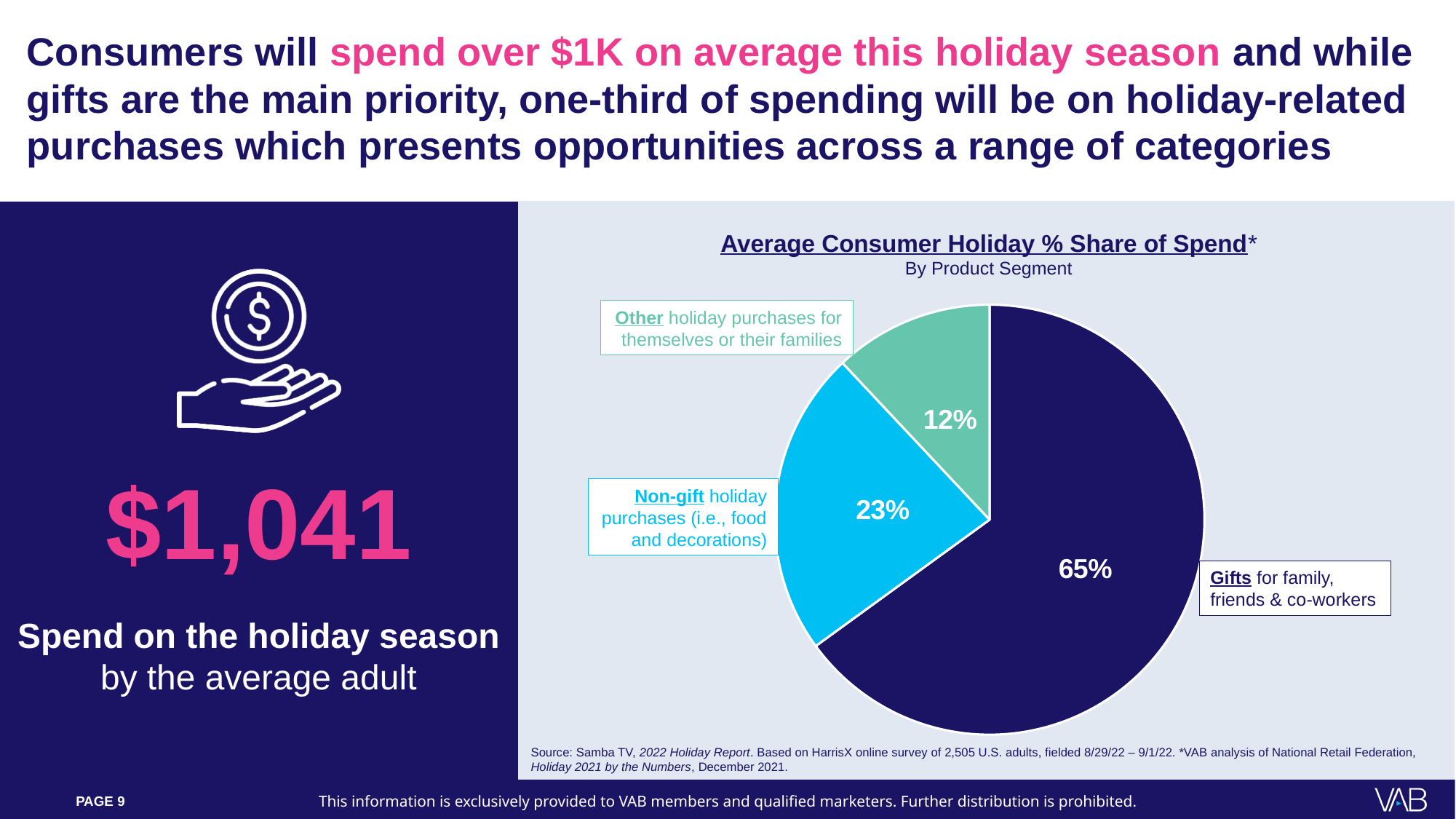
What kind of chart is used to show the share of spend by product segment? Pie chart What colour is the slice for non-gift holiday purchases? Light blue What share of holiday spend goes to non-gift holiday purchases (i.e., food and decorations)? 23% Which product segment has the smallest share of holiday spend? Other holiday purchases for themselves or their families How many product segments are shown in the pie chart? 3 Which has a larger share of spend: non-gift holiday purchases or other holiday purchases? Non-gift holiday purchases What is the title of the chart? Average Consumer Holiday % Share of Spend What share of holiday spend goes to other holiday purchases for themselves or their families? 12% What is the difference in share between non-gift holiday purchases and other holiday purchases? 11 percentage points What is the difference in share between gifts and non-gift holiday purchases? 42 percentage points Which product segment has the largest share of holiday spend? Gifts for family, friends & co-workers What share of holiday spend goes to gifts for family, friends & co-workers? 65%